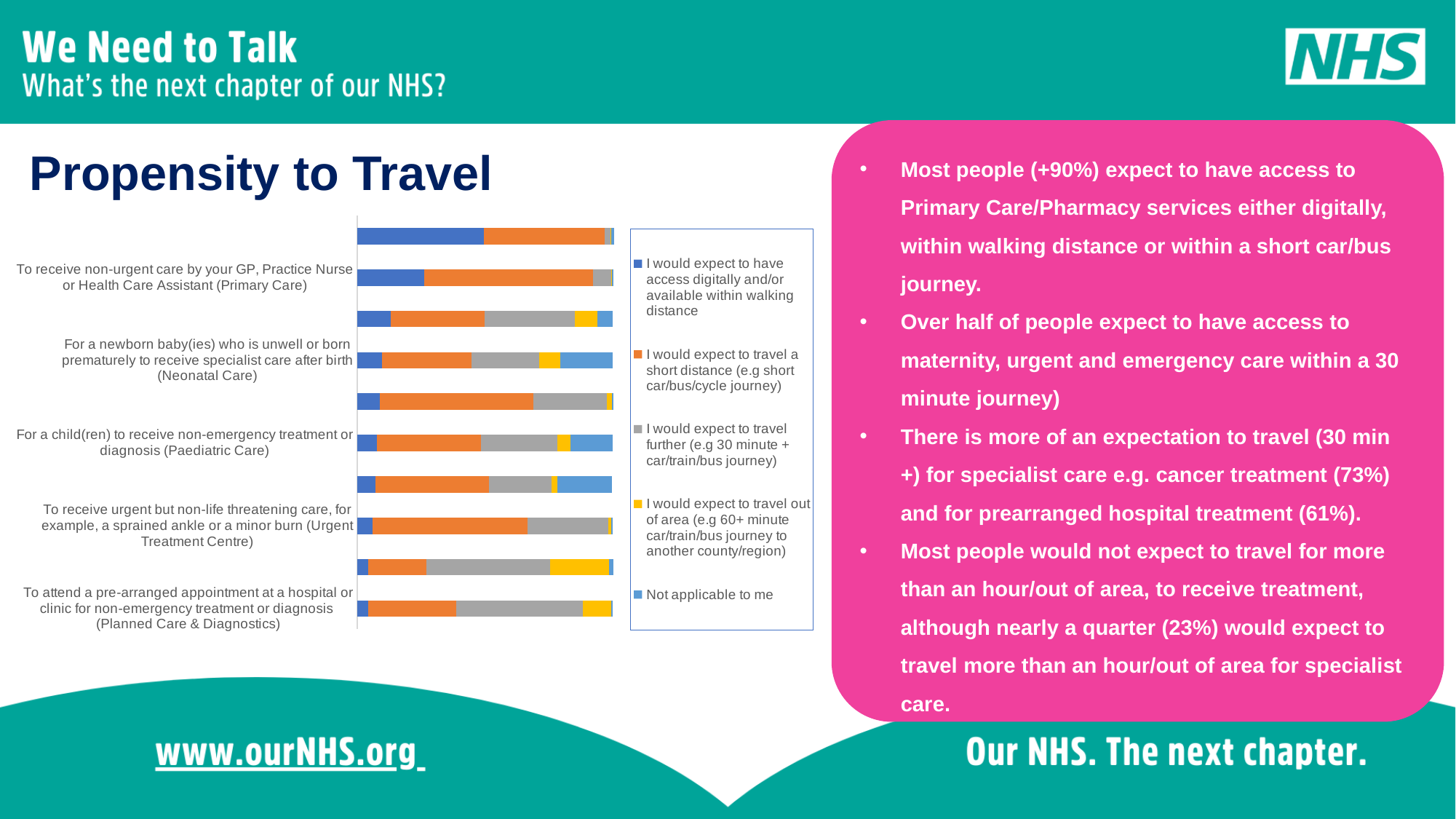
How many series does the chart's legend list? 5 In the bar for Neonatal Care, which response segment is the largest? I would expect to travel a short distance (e.g short car/bus/cycle journey) In the bar for a pre-arranged appointment at a hospital or clinic (Planned Care & Diagnostics), which response segment is the largest? I would expect to travel further (e.g 30 minute + car/train/bus journey) In the bar for Neonatal Care, which segment is larger: 'Not applicable to me' or 'travel out of area'? Not applicable to me How many bars are plotted in the chart? 10 In the bar for non-urgent care by your GP, Practice Nurse or Health Care Assistant (Primary Care), which segment is larger: 'access digitally and/or within walking distance' or 'travel a short distance'? Travel a short distance Which legend entry is shown in orange? I would expect to travel a short distance (e.g short car/bus/cycle journey) What kind of chart is shown on the slide? Stacked bar chart In the bar for Planned Care & Diagnostics, which segment is larger: 'access digitally and/or within walking distance' or 'travel out of area'? Travel out of area What colour represents 'Not applicable to me' in the chart? Light blue